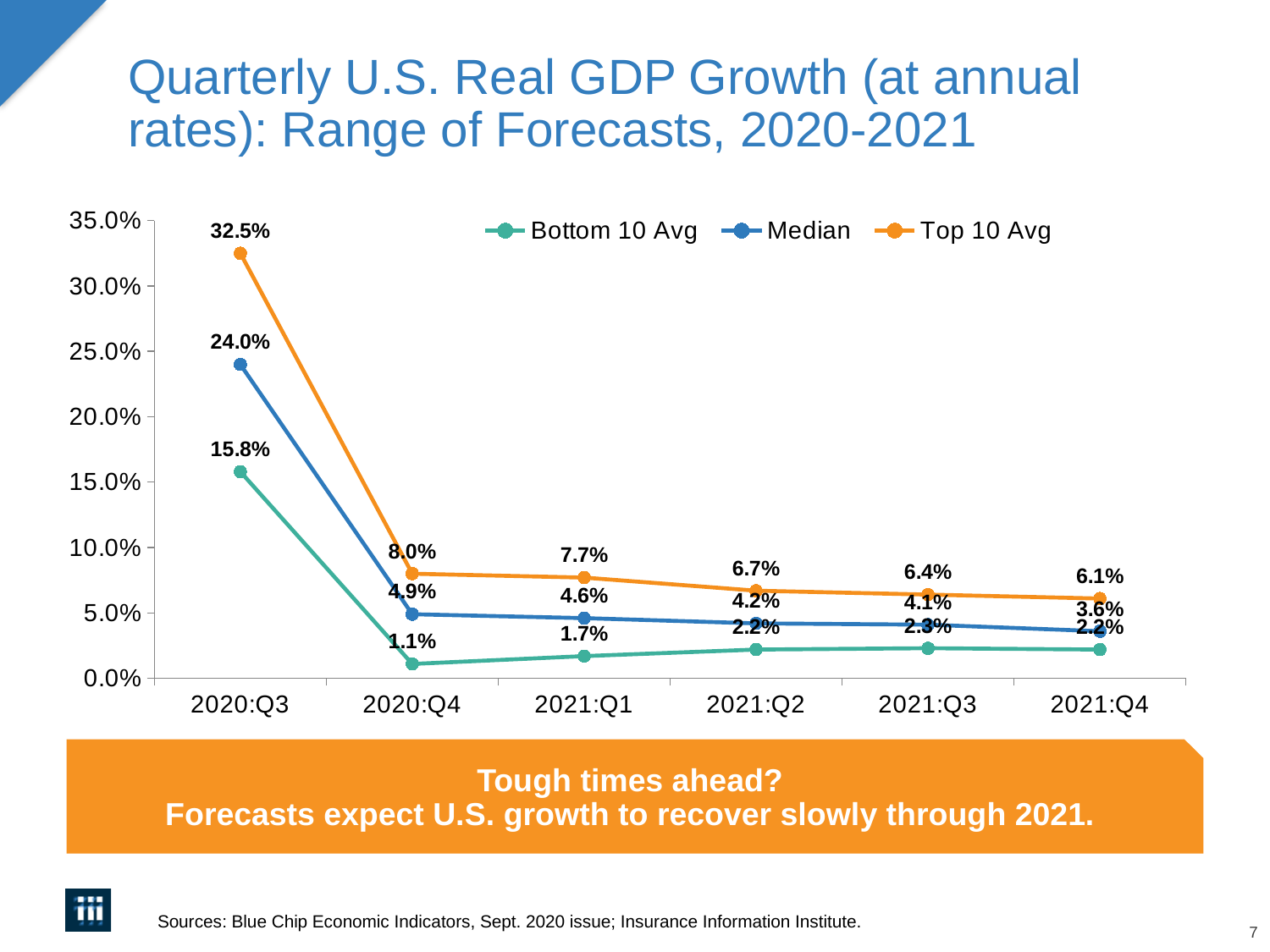
Does the Top 10 Avg line rise or fall from 2020:Q3 to 2021:Q4? fall Is the Top 10 Avg value for 2020:Q4 greater or less than 10.0%? less What kind of chart is shown on the slide? line chart In which quarter is the Top 10 Avg forecast highest? 2020:Q3 Which is larger for 2020:Q3, the Median forecast or the Bottom 10 Avg forecast? Median What is the Median forecast for 2020:Q4? 4.9% How many series does the legend list? 3 What is the Bottom 10 Avg forecast for 2021:Q1? 1.7% What is the Top 10 Avg forecast for 2020:Q3? 32.5% What is the difference between the Top 10 Avg and the Median forecasts for 2020:Q3? 8.5 percentage points How many quarters are plotted along the x axis? 6 In which quarter is the Bottom 10 Avg forecast lowest? 2020:Q4